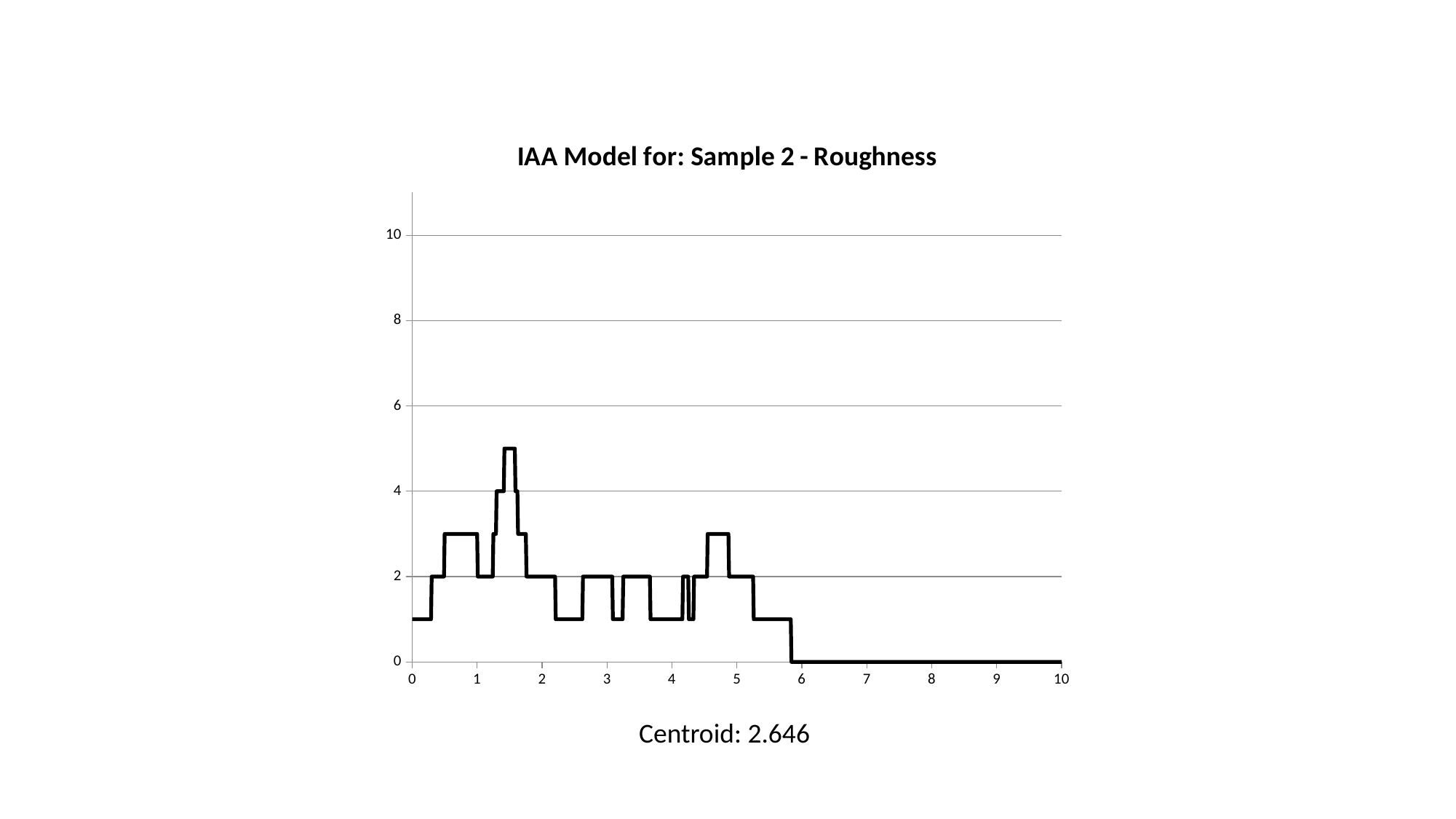
What kind of chart is shown on the slide? line chart Is the value of the line at x = 0 greater or less than 2? less What is the value of the line at x = 10? 0 Is the highest point of the line greater or less than 4? greater What is the value of the line at x = 2? 2 What is the value of the line at x = 8? 0 What centroid value is stated below the chart? 2.646 Between which two x-axis tick labels does the line reach its highest point? between 1 and 2 Does the line rise or fall as x goes from 5 to 7? fall Is the highest point of the line greater or less than 6? less What is the title of the chart? IAA Model for: Sample 2 - Roughness Which is larger: the peak of the line between x = 1 and x = 2, or the peak between x = 4 and x = 5? the peak between x = 1 and x = 2